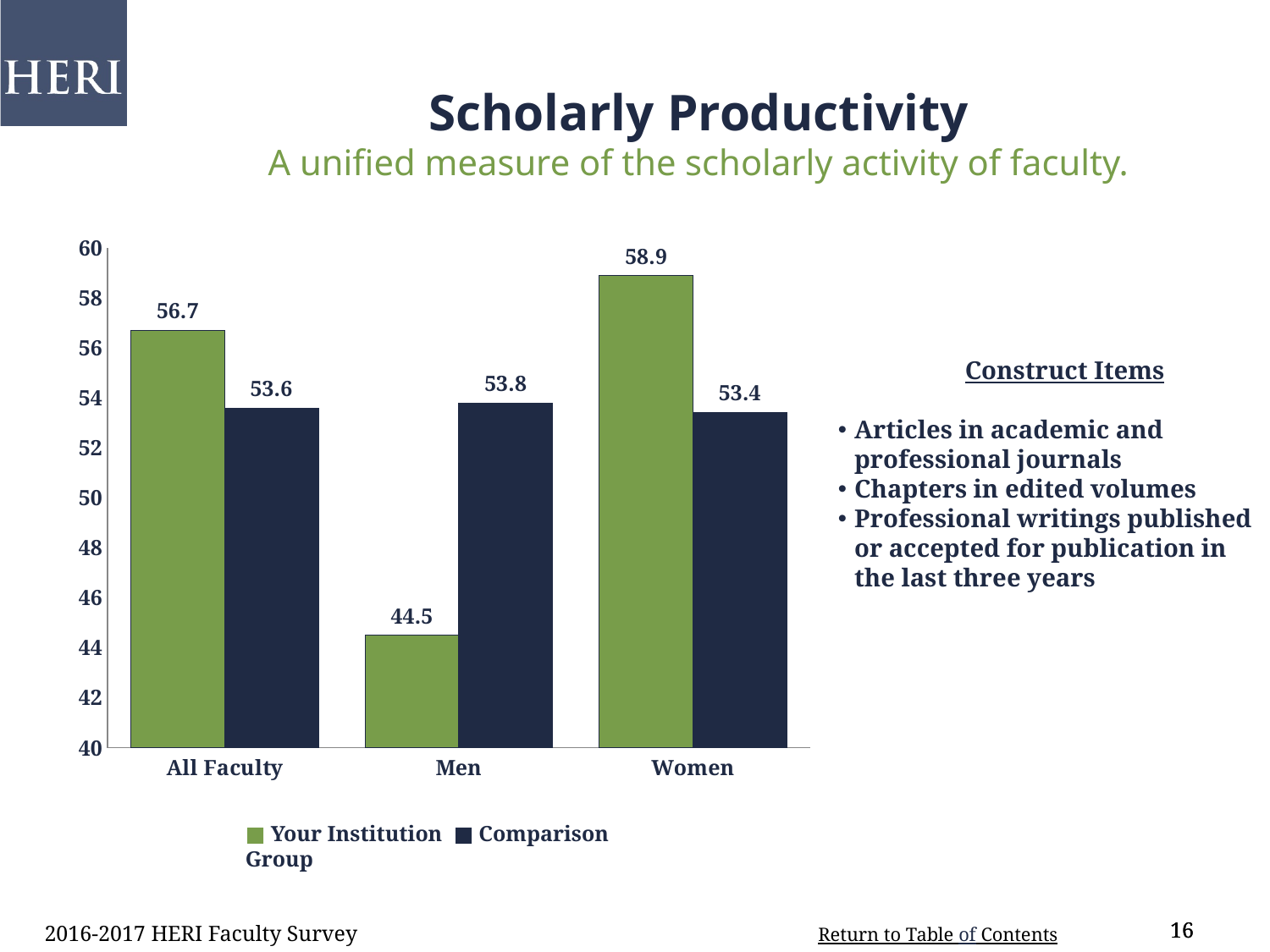
How many series does the legend list? 2 What is the difference between the Your Institution and Comparison Group values for Women? 5.5 Which is larger for All Faculty: Your Institution or Comparison Group? Your Institution What is the Your Institution value for All Faculty? 56.7 What is the difference between the Your Institution and Comparison Group values for Men? 9.3 How many categories are shown on the x axis? 3 Is the Your Institution value for Men greater or less than 50? less What is the Your Institution value for Women? 58.9 What kind of chart is shown on the slide? bar chart Which category has the lowest Your Institution value? Men Which category has the highest Your Institution value? Women What is the Comparison Group value for Men? 53.8